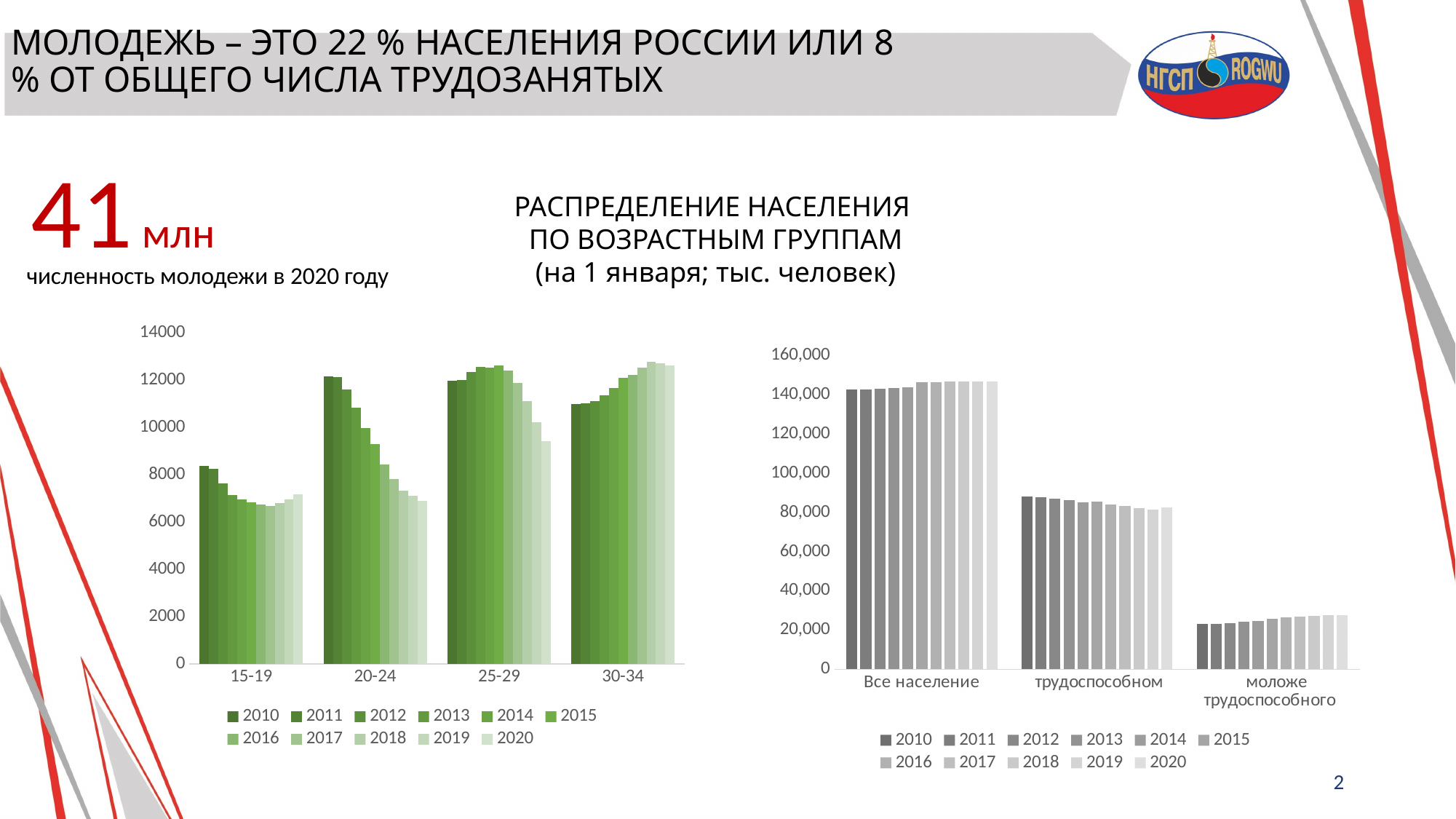
In the left chart, which has the larger 2010 value: the 15-19 age group or the 30-34 age group? 30-34 In the left chart, is the 2010 value for the 20-24 age group greater or less than 10000? greater How many series does the legend of the left chart list? 11 In the right chart, which category has the highest values? Все население How many categories are shown on the x axis of the right chart? 3 In the right chart, do the values for 'моложе трудоспособного' rise or fall from 2010 to 2020? rise In the right chart, is the 2010 value for 'трудоспособном' greater or less than 80,000? greater In the right chart, which category has the lowest values? моложе трудоспособного How many age-group categories are shown on the x axis of the left chart? 4 In the left chart, is the 2020 value for the 20-24 age group greater or less than 8000? less What kind of chart is the chart on the left of the slide? bar chart In the left chart, do the values for the 20-24 age group rise or fall from 2010 to 2020? fall